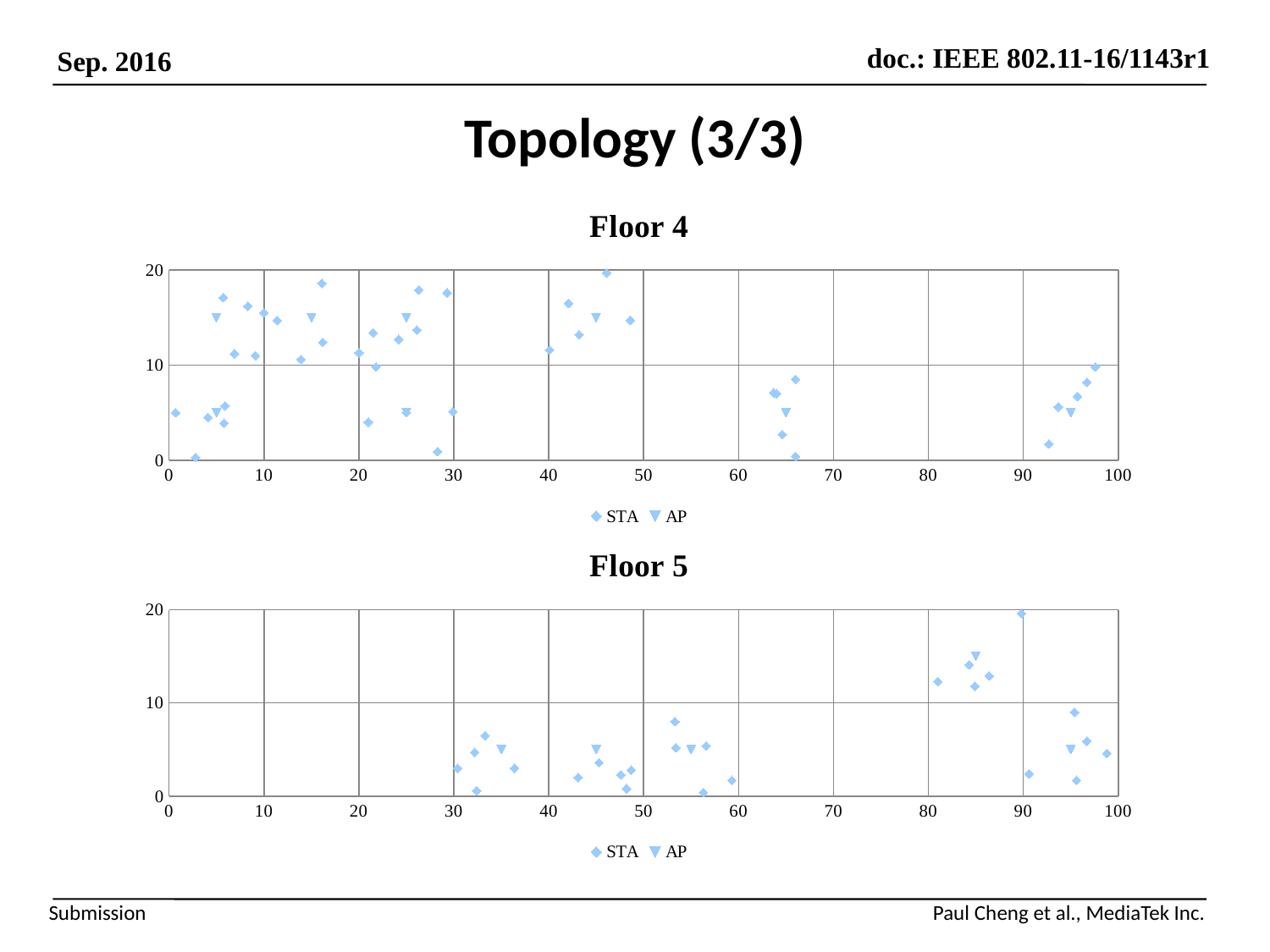
On the Floor 4 chart, is the y value of the highest STA point (near x = 46) greater or less than 15? greater On the Floor 5 chart, is the y value of the AP point near x = 85 greater or less than 10? greater On the Floor 5 chart, how many points are plotted with an x value below 30? 0 What is the title of the top chart on the slide? Floor 4 On the Floor 5 chart, how many AP points (triangles) are plotted? 5 How many series does the legend of the Floor 5 chart list? 2 On the Floor 5 chart, is the y value of the STA point near x = 90 greater or less than 15? greater What are the two legend entries on the Floor 5 chart? STA and AP How many series does the legend of the Floor 4 chart list? 2 What kind of chart is the Floor 4 chart? scatter chart What kind of chart is the Floor 5 chart? scatter chart